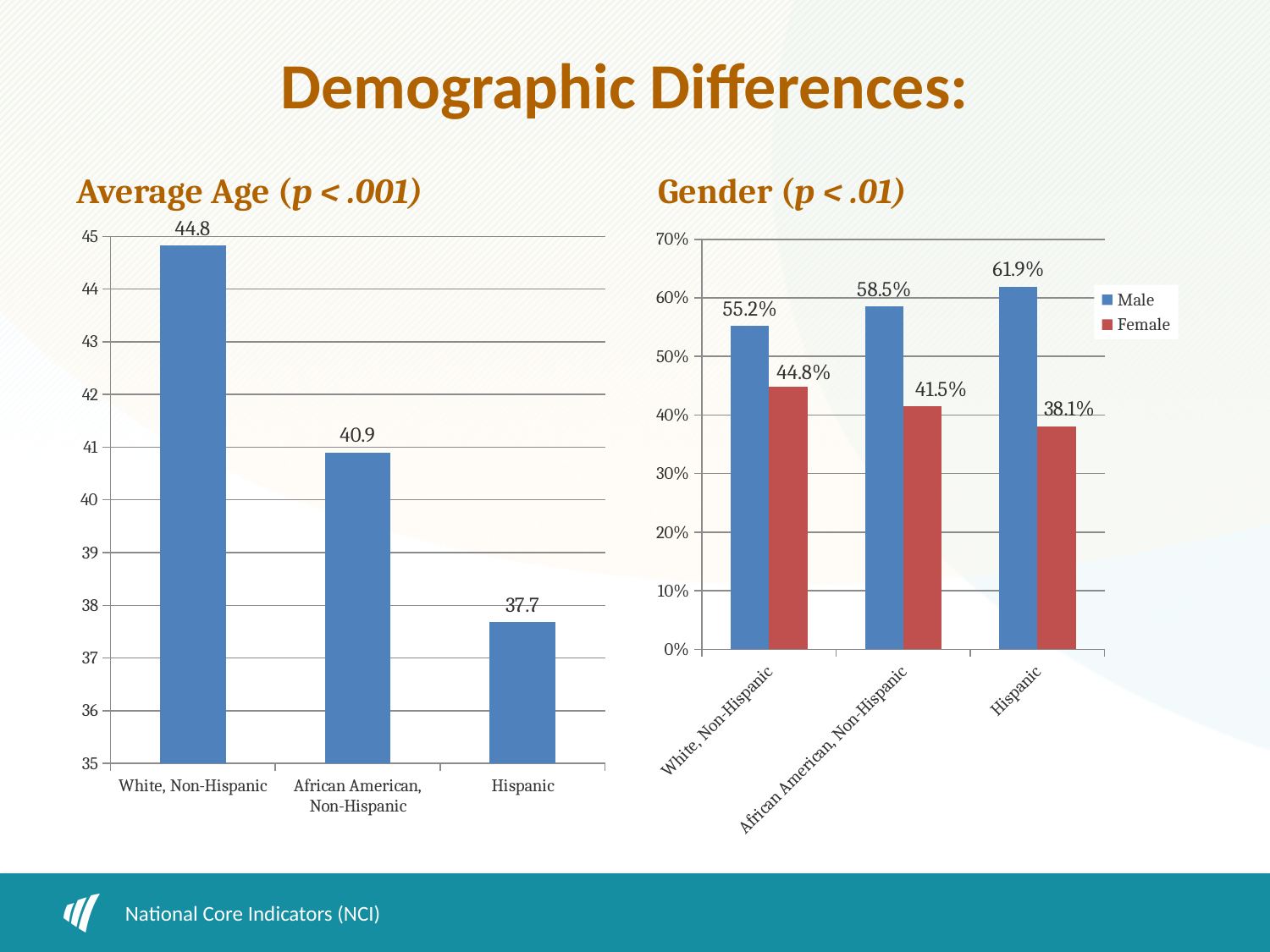
In the Average Age chart, which category has the lowest average age? Hispanic What kind of chart is the Gender chart? bar chart In the Gender chart, what is the Female value for African American, Non-Hispanic? 41.5% In the Average Age chart, how many categories are shown? 3 In the Average Age chart, do the values rise or fall from left to right along the x axis? fall In the Average Age chart, what is the difference between the average age for White, Non-Hispanic and Hispanic? 7.1 In the Gender chart, which category has the highest Male value? Hispanic In the Gender chart, which is larger for White, Non-Hispanic: the Male value or the Female value? Male In the Average Age chart, what is the average age for White, Non-Hispanic? 44.8 In the Gender chart, what is the difference between the Male and Female values for Hispanic? 23.8% In the Gender chart, what is the Male value for Hispanic? 61.9% In the Gender chart, how many series does the legend list? 2